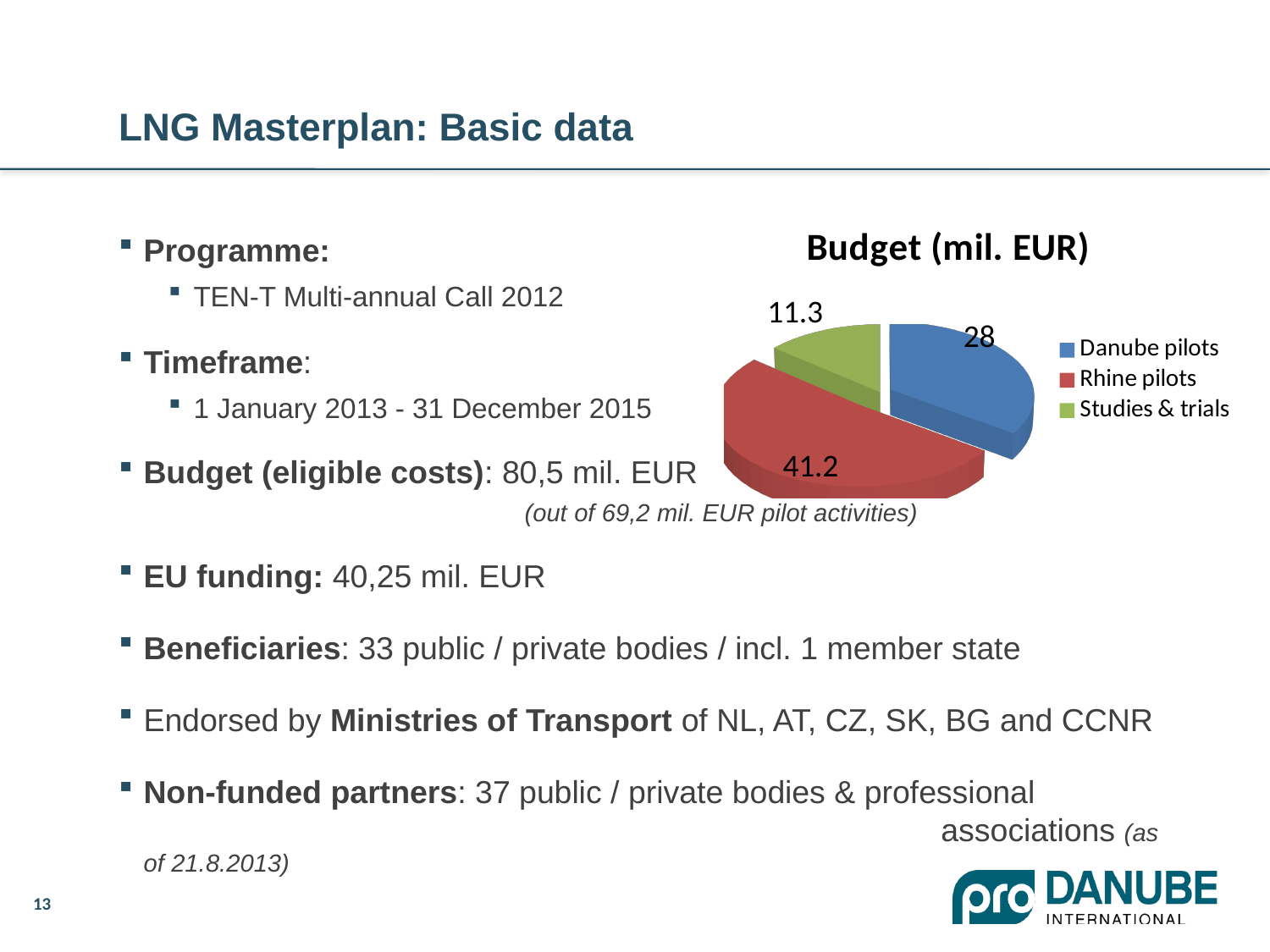
What is the difference between the values for Rhine pilots and Danube pilots? 13.2 Which is larger, the value for Danube pilots or the value for Studies & trials? Danube pilots Which category has the largest slice in the Budget (mil. EUR) chart? Rhine pilots What is the title of the chart? Budget (mil. EUR) What is the value for Rhine pilots in the Budget (mil. EUR) chart? 41.2 Which category has the smallest slice in the Budget (mil. EUR) chart? Studies & trials What is the value for Danube pilots in the Budget (mil. EUR) chart? 28 What colour is the Rhine pilots slice in the pie chart? red What is the value for Studies & trials in the Budget (mil. EUR) chart? 11.3 How many entries does the legend list? 3 What kind of chart is shown on the slide? pie chart How many categories does the pie chart show? 3